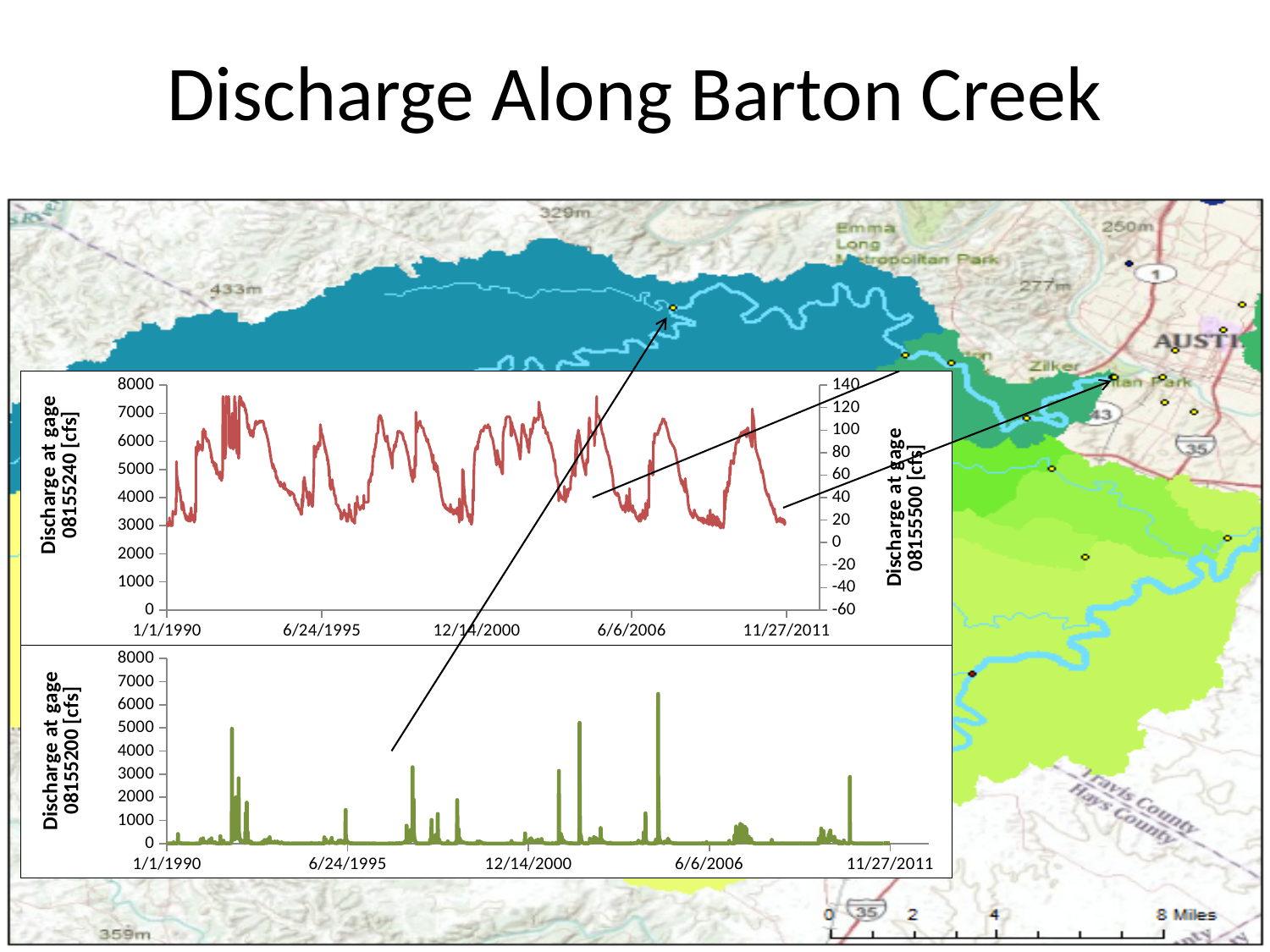
What kind of chart is the top chart (the one with the red line)? line chart What kind of chart is the bottom chart (the one with the green line)? line chart In the top chart, is the lowest point of the red line (read on the left axis) greater or less than 2000? greater In the bottom chart, is the highest spike of the green line greater or less than 7000? less In the bottom chart, what is the label of the vertical axis? Discharge at gage 08155200 [cfs] In the bottom chart, is the first large spike (around 1991-1992) greater or less than 4000? greater In the top chart, what is the label of the left vertical axis? Discharge at gage 08155240 [cfs] What is the first date shown on the x axis of the top chart? 1/1/1990 What is the last date shown on the x axis of the bottom chart? 11/27/2011 How many date labels are shown along the x axis of the bottom chart? 5